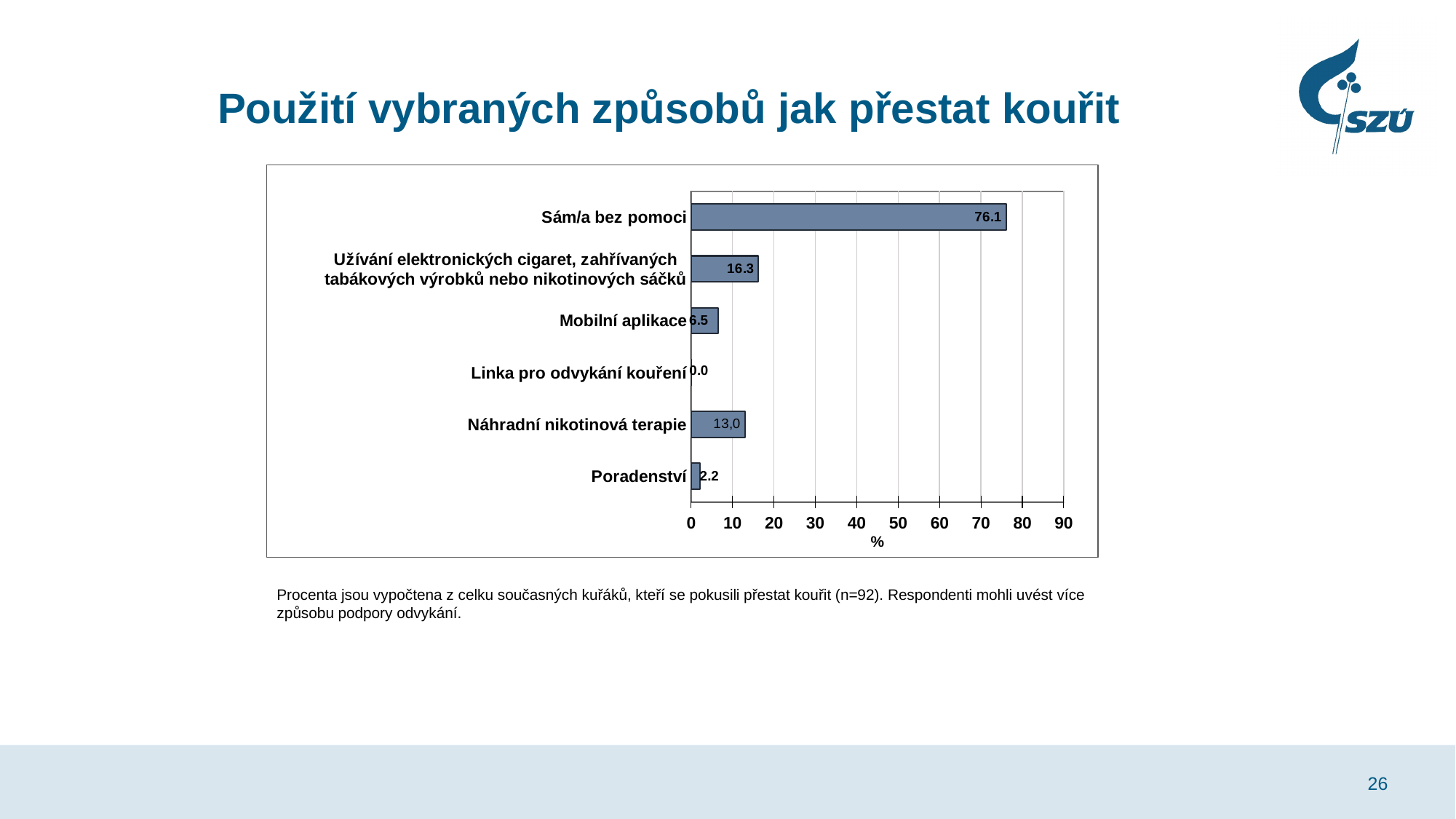
What kind of chart is shown on the slide? bar chart What is the value for Mobilní aplikace? 6.5 What is the difference between the values for Sám/a bez pomoci and Užívání elektronických cigaret, zahřívaných tabákových výrobků nebo nikotinových sáčků? 59.8 How many categories are shown in the chart? 6 What is the value for Poradenství? 2.2 What is the value for Sám/a bez pomoci? 76.1 What is the value for Náhradní nikotinová terapie? 13,0 Which is larger, the value for Mobilní aplikace or the value for Poradenství? Mobilní aplikace Which category has the highest value? Sám/a bez pomoci Which category has the lowest value? Linka pro odvykání kouření Is the value for Sám/a bez pomoci greater or less than 70? greater What is the value for Linka pro odvykání kouření? 0.0